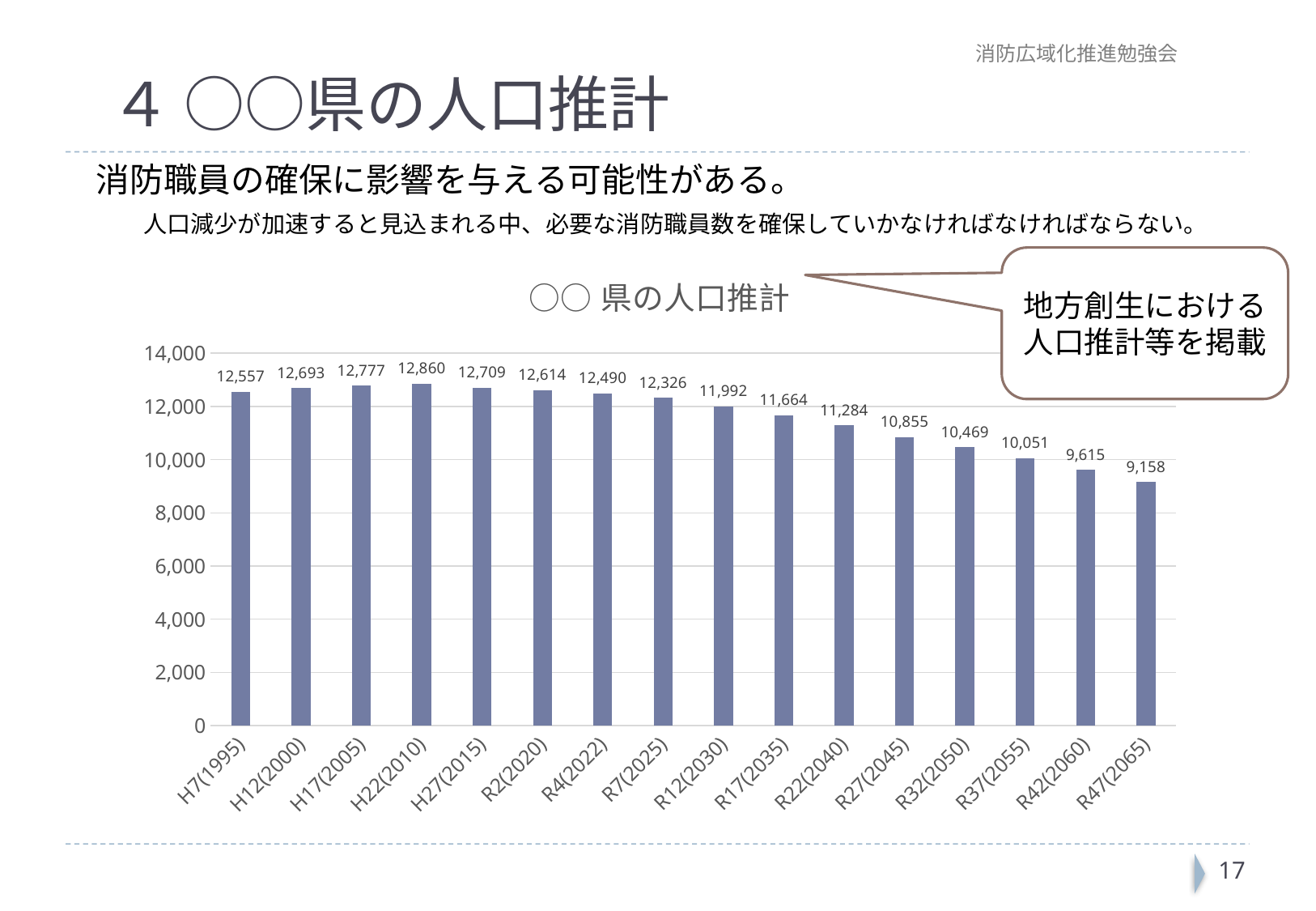
Which is larger, the value for H12(2000) or the value for R2(2020)? H12(2000) How many categories are shown on the x axis? 16 Is the value for R27(2045) greater or less than 12,000? less Do the values rise or fall from H22(2010) to R47(2065)? fall What is the value for H7(1995)? 12,557 What is the value for R12(2030)? 11,992 What kind of chart is shown on the slide? bar chart What is the value for R47(2065)? 9,158 Which category has the highest value? H22(2010) Which category has the lowest value? R47(2065) What is the difference between the values for H22(2010) and R47(2065)? 3,702 What is the title of the chart? ○○ 県の人口推計